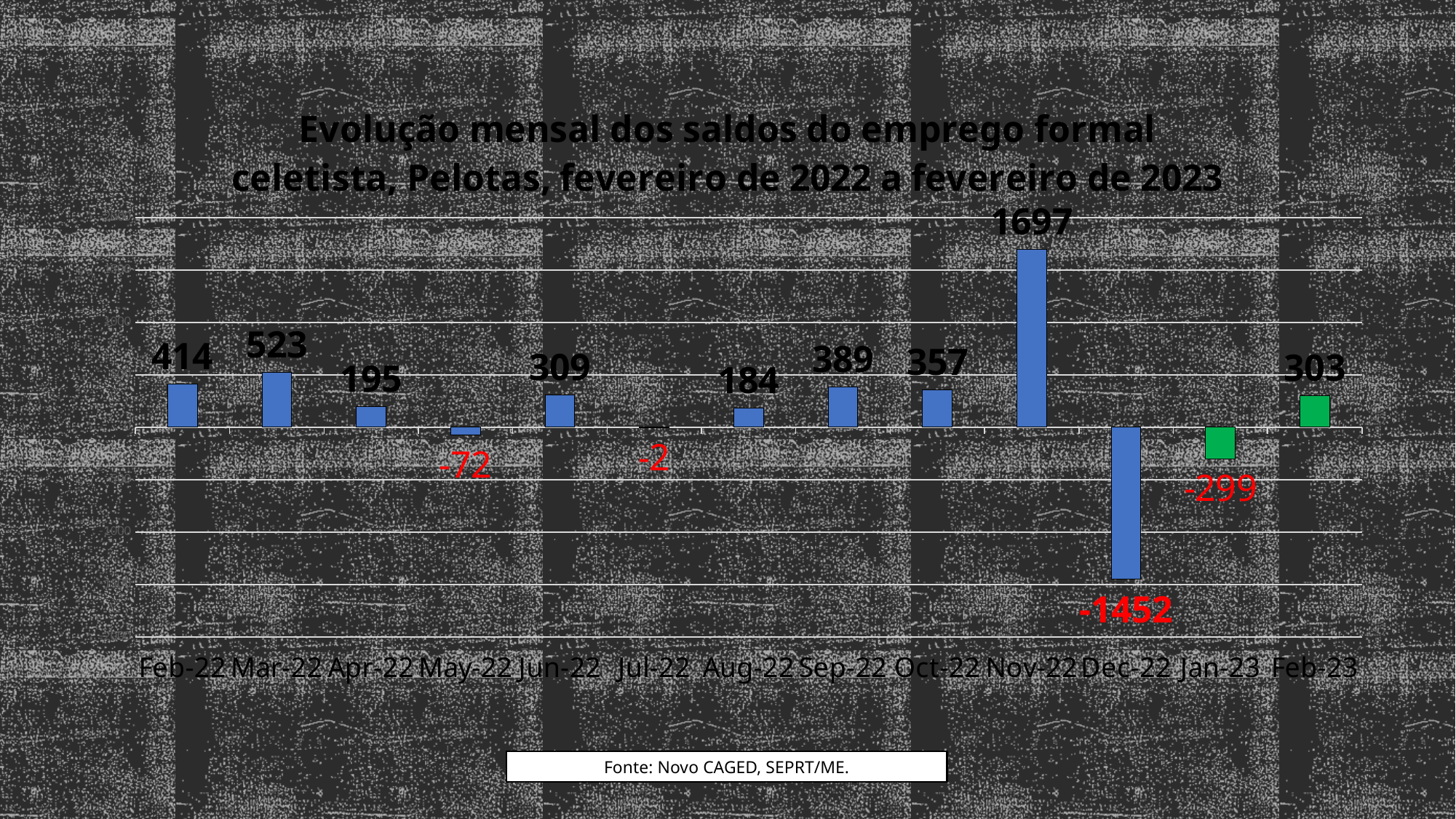
What is the difference between the values for Mar-22 and Feb-22? 109 How many months have a negative value? 4 Which month has the highest value? Nov-22 Which is larger, the value for Sep-22 or the value for Oct-22? Sep-22 What is the value for Dec-22? -1452 What kind of chart is shown on the slide? Bar chart What is the value for Feb-23? 303 How many months are plotted on the chart? 13 What is the value for Nov-22? 1697 What is the source cited below the chart? Novo CAGED, SEPRT/ME. What is the value for May-22? -72 Which month has the lowest value? Dec-22